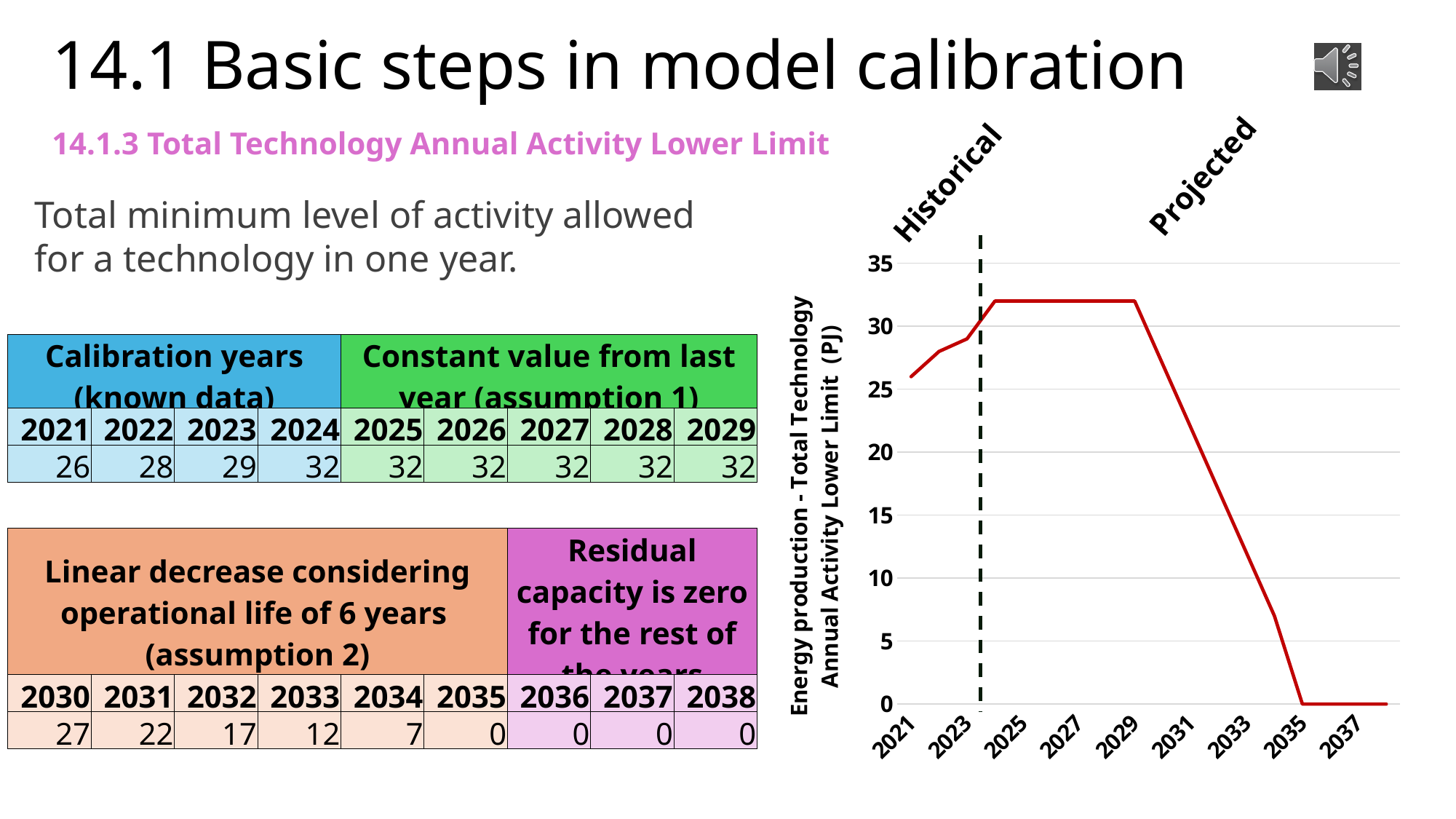
What two labels mark the regions on either side of the dashed vertical line in the chart? Historical and Projected According to the slide, what is the value for 2024? 32 According to the slide, what is the Total Technology Annual Activity Lower Limit value for 2021? 26 According to the slide, what is the value for 2032? 17 What is the highest value reached by the line in the chart? 32 Does the plotted line rise or fall between 2029 and 2035? fall What kind of chart is shown on the right of the slide? line chart Is the value plotted for 2033 greater or less than 15? less Is the value plotted for 2029 greater or less than 30? greater What is the y-axis label of the chart? Energy production - Total Technology Annual Activity Lower Limit (PJ) Which is larger, the value for 2030 or the value for 2034? 2030 What is the difference between the value for 2024 and the value for 2021? 6